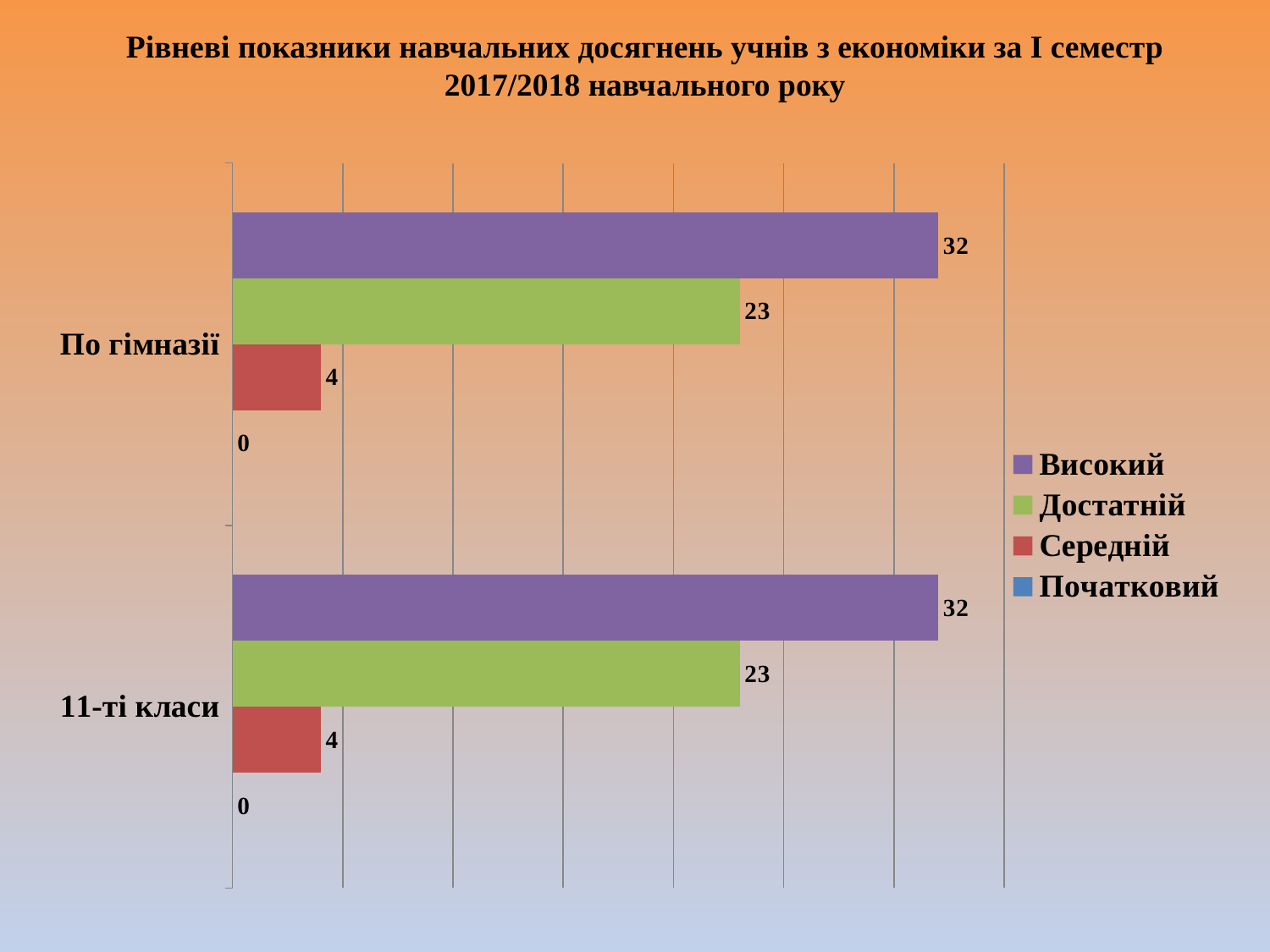
What is the value for Високий in the По гімназії category? 32 How many series does the legend list? 4 What colour are the Достатній bars? Green What is the value for Достатній in the 11-ті класи category? 23 What is the value for Середній in the По гімназії category? 4 Which series has the lowest value in the По гімназії category? Початковий Which is larger in the 11-ті класи category: Достатній or Середній? Достатній What is the difference between the Високий and Достатній values in the По гімназії category? 9 What is the value for Початковий in the 11-ті класи category? 0 What kind of chart is shown on the slide? Bar chart How many categories are shown on the chart? 2 Which series has the highest value in the 11-ті класи category? Високий